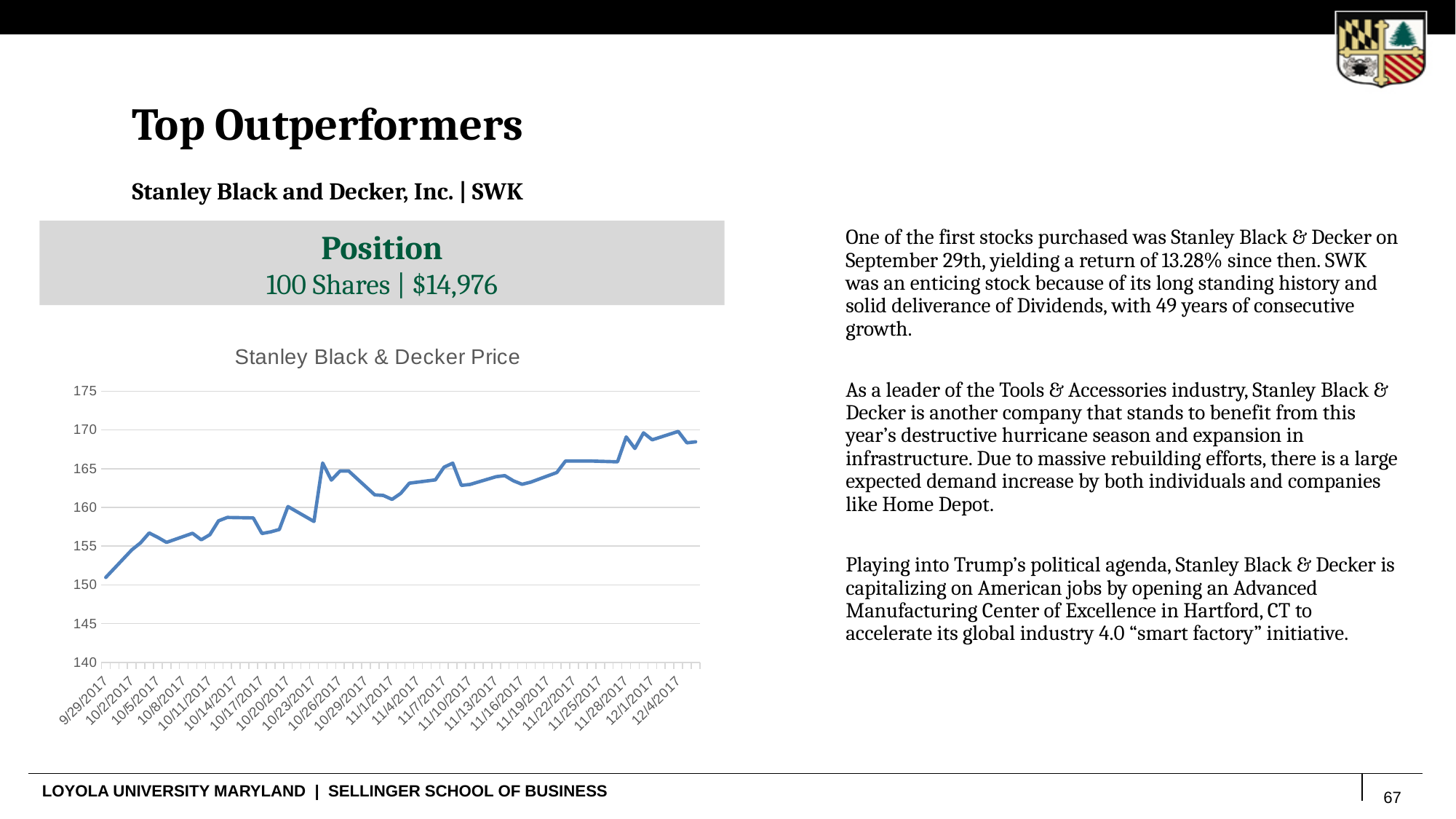
Is the value for 11/28/2017 greater or less than 165? greater Overall, do the values rise or fall from 9/29/2017 to 12/4/2017? rise Is the value for 12/4/2017 greater or less than 165? greater Is the value for 10/23/2017 greater or less than 160? less What kind of chart is shown on the slide? line chart Which is larger, the value for 12/4/2017 or the value for 9/29/2017? 12/4/2017 What is the highest tick value shown on the y axis? 175 Which date on the x axis has the lowest price? 9/29/2017 What is the title of the chart? Stanley Black & Decker Price